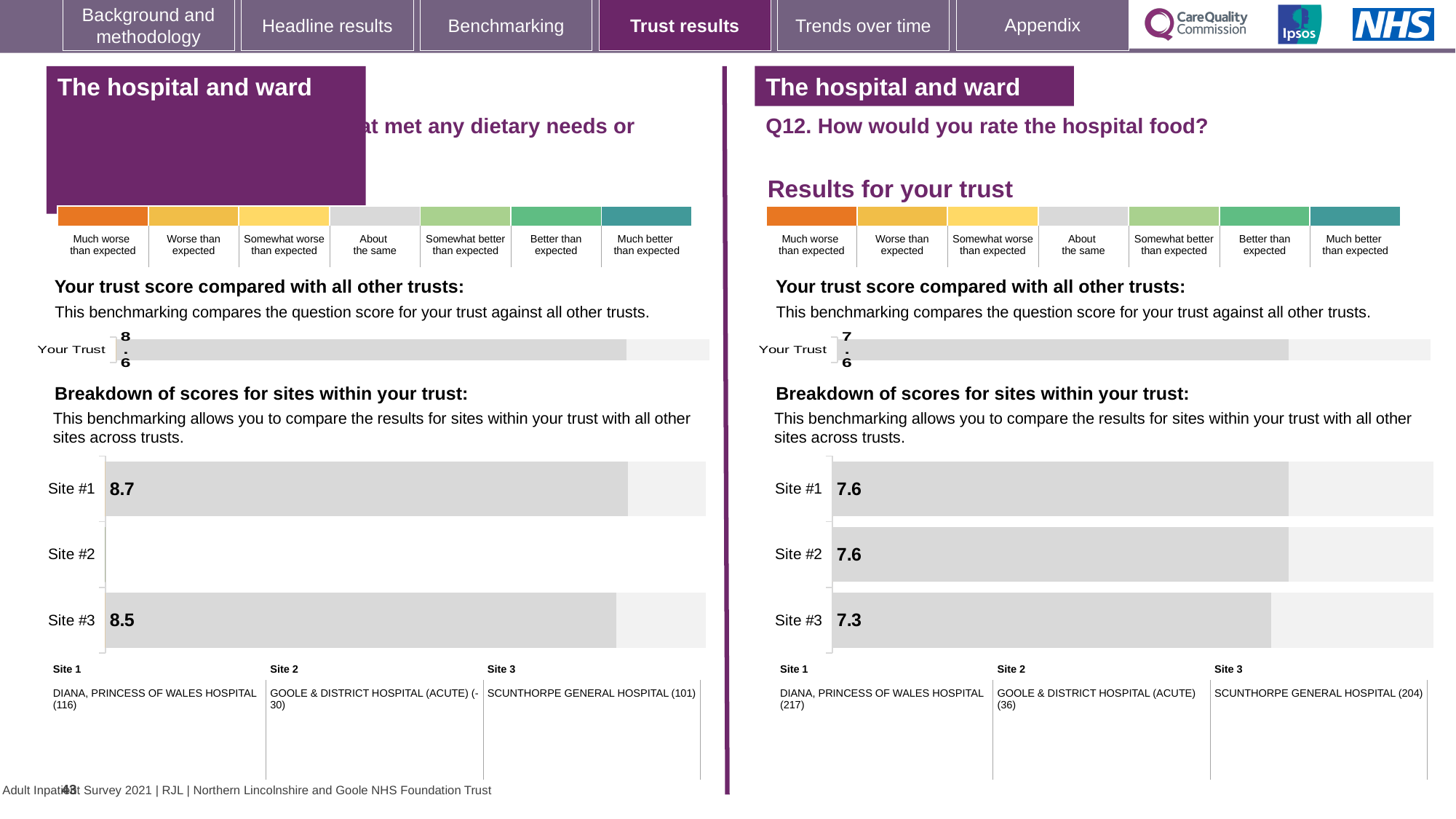
On the right-hand chart for Q12 (hospital food), what is the score for Your Trust? 7.6 On the right-hand site breakdown chart for Q12, what is the difference between the scores for Site #1 and Site #3? 0.3 On the right-hand site breakdown chart for Q12, which site has the lowest score? Site #3 How many sites are listed on the right-hand site breakdown chart for Q12? 3 On the right-hand site breakdown chart for Q12, what is the score for Site #2? 7.6 On the left-hand 'Your Trust' chart, what is the trust score? 8.6 On the left-hand site breakdown chart, which site has the higher score, Site #1 or Site #3? Site #1 On the left-hand site breakdown chart, what is the difference between the scores for Site #1 and Site #3? 0.2 On the left-hand site breakdown chart, what is the score for Site #3? 8.5 What type of chart is used for the site breakdown on the right-hand side of the slide? Bar chart On the left-hand site breakdown chart, what is the score for Site #1? 8.7 On the right-hand site breakdown chart for Q12, what is the score for Site #3? 7.3